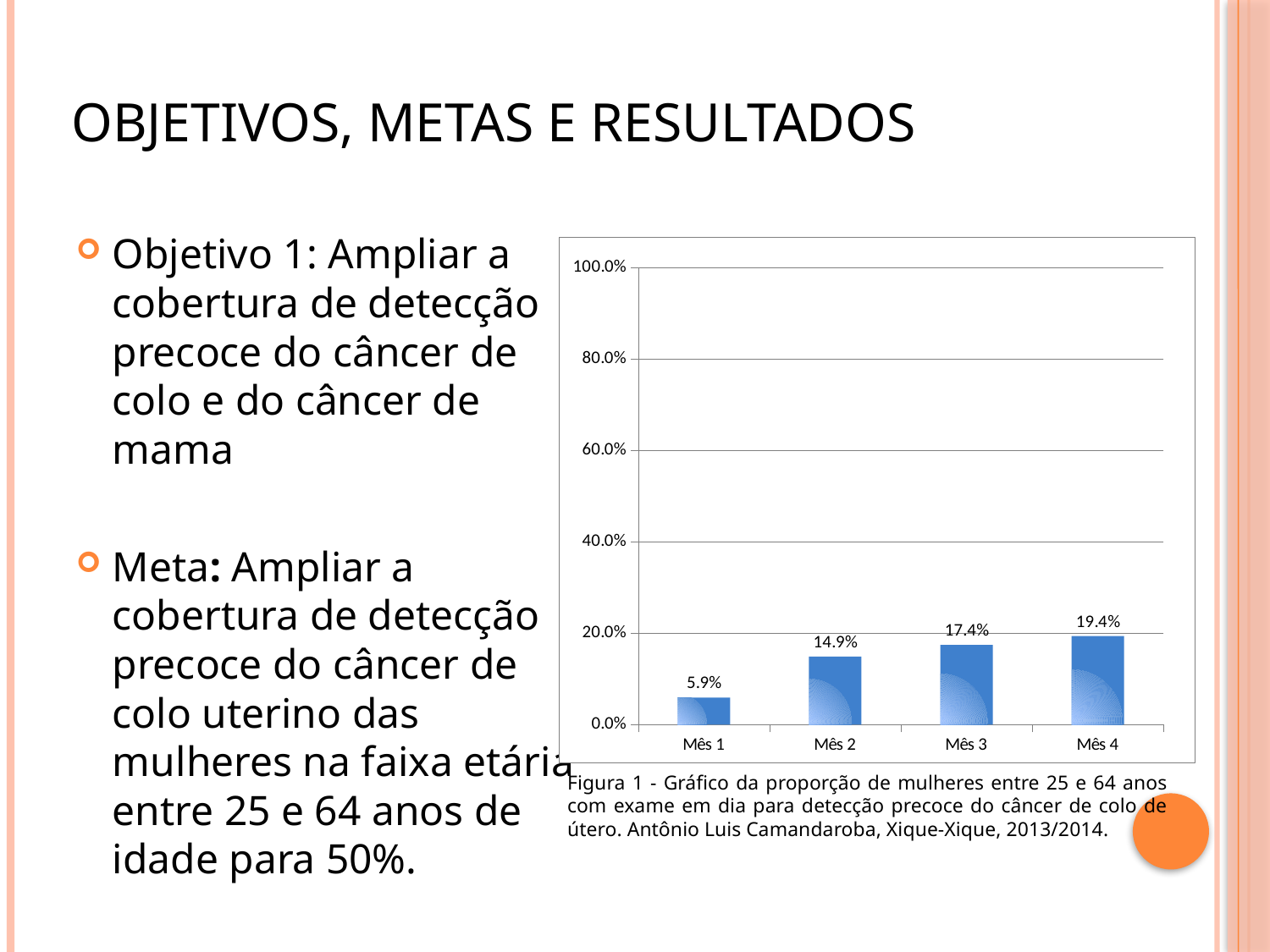
What is the difference between the values for Mês 2 and Mês 1? 9.0% Which is larger, the value for Mês 2 or the value for Mês 3? Mês 3 How many months are shown on the x axis? 4 What kind of chart is shown on the slide? bar chart What is the value for Mês 4? 19.4% What is the value for Mês 3? 17.4% Which month has the lowest value? Mês 1 Do the values rise or fall from Mês 1 to Mês 4? rise Is the value for Mês 4 greater or less than 20.0%? less Which month has the highest value? Mês 4 What is the value for Mês 1? 5.9% What is the difference between the values for Mês 4 and Mês 3? 2.0%